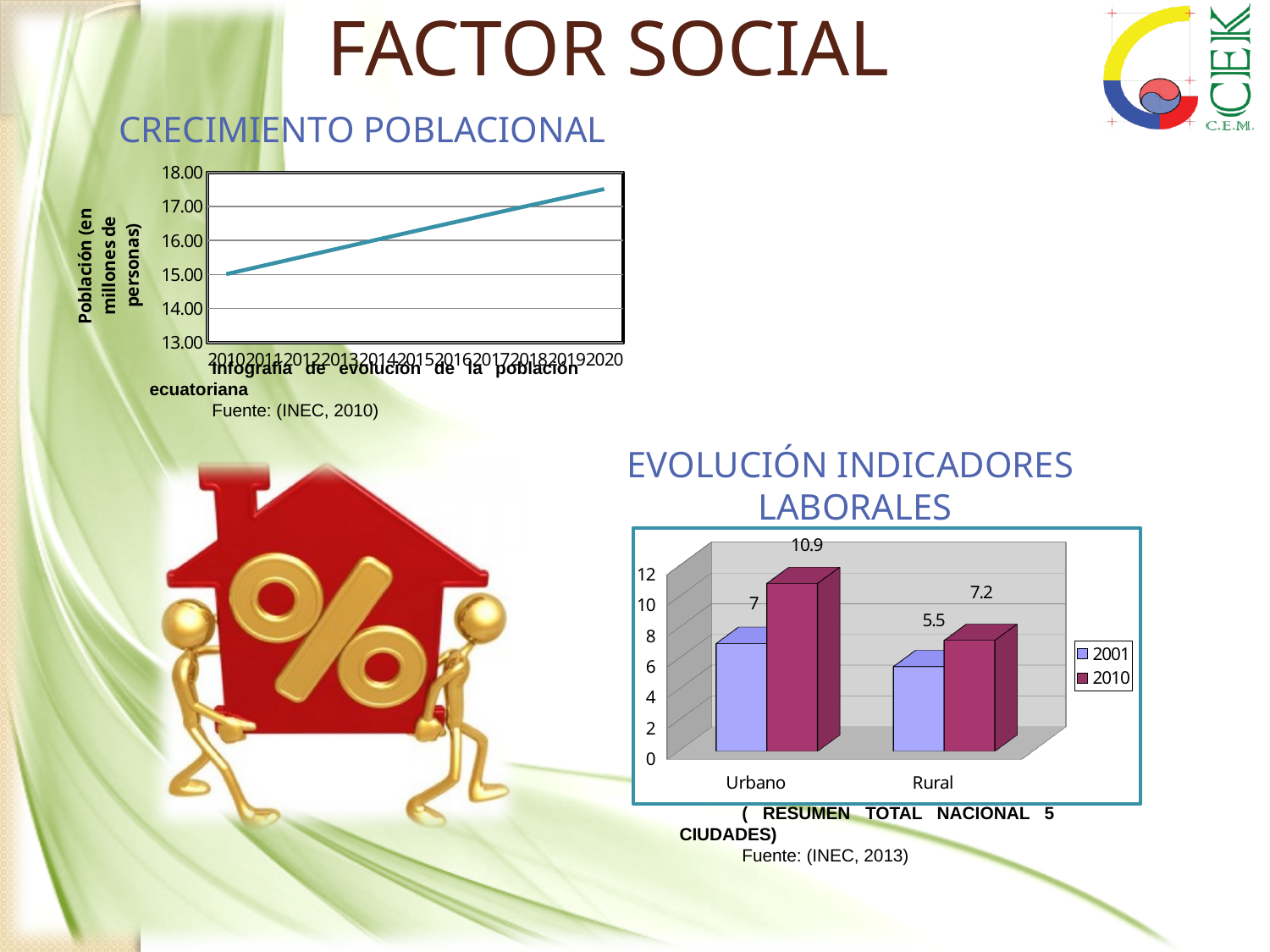
In the CRECIMIENTO POBLACIONAL chart, does the population rise or fall from 2010 to 2020? Rise How many series does the legend of the EVOLUCIÓN INDICADORES LABORALES chart list? 2 In the EVOLUCIÓN INDICADORES LABORALES chart, which is larger: Rural in 2010 or Urbano in 2001? Rural in 2010 In the EVOLUCIÓN INDICADORES LABORALES chart, what is the value for Rural in 2001? 5.5 What kind of chart is the CRECIMIENTO POBLACIONAL chart? Line chart What kind of chart is the EVOLUCIÓN INDICADORES LABORALES chart? Bar chart In the EVOLUCIÓN INDICADORES LABORALES chart, what is the value for Rural in 2010? 7.2 In the EVOLUCIÓN INDICADORES LABORALES chart, which bar has the highest value? Urbano 2010 In the EVOLUCIÓN INDICADORES LABORALES chart, what is the difference between the Urbano values for 2010 and 2001? 3.9 In the CRECIMIENTO POBLACIONAL chart, is the value for 2020 greater or less than 17.00? greater In the EVOLUCIÓN INDICADORES LABORALES chart, what is the value for Urbano in 2001? 7 In the EVOLUCIÓN INDICADORES LABORALES chart, what is the value for Urbano in 2010? 10.9